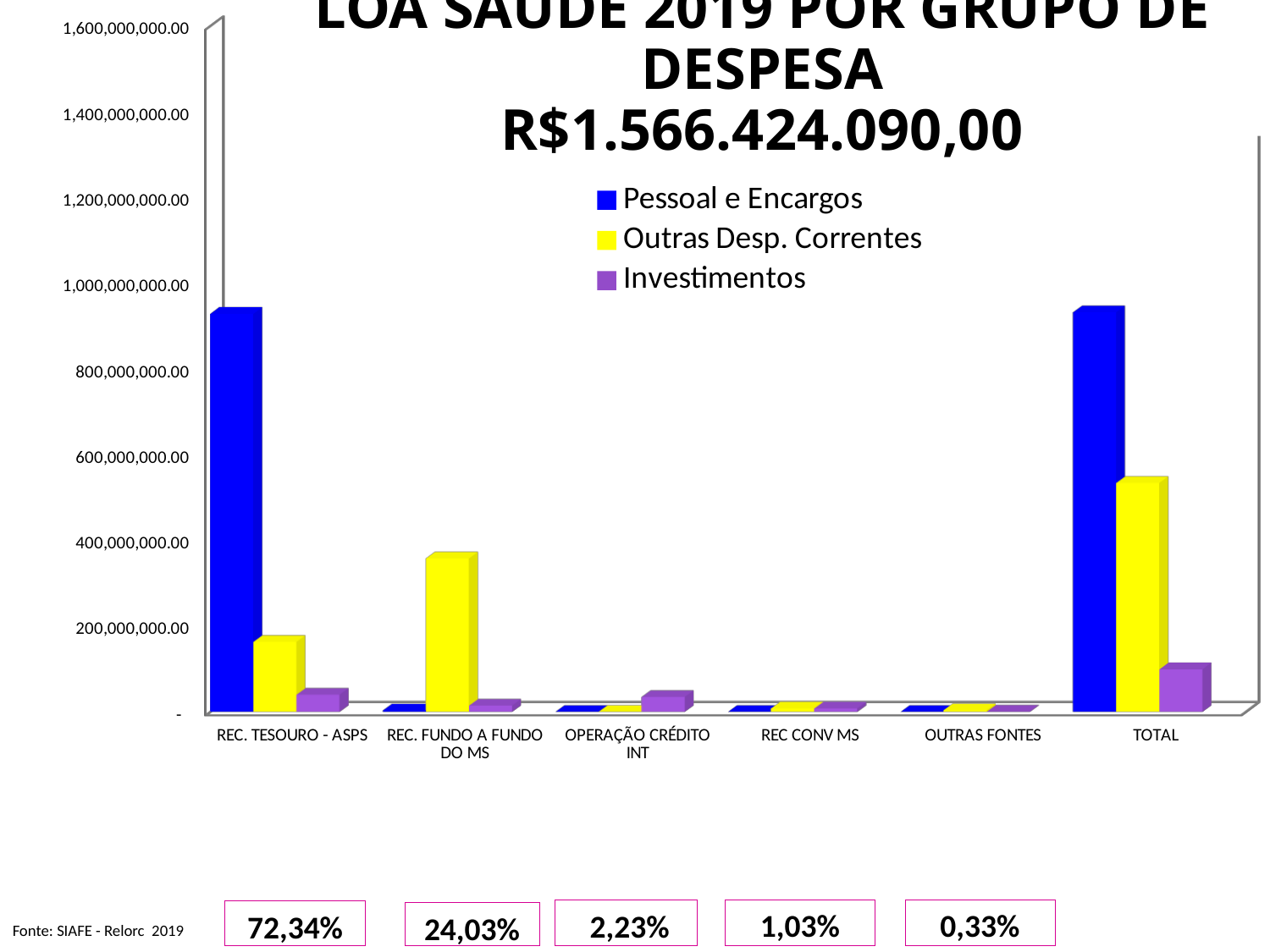
Which series are listed in the legend? Pessoal e Encargos, Outras Desp. Correntes, Investimentos For REC. TESOURO - ASPS, which is larger: Pessoal e Encargos or Outras Desp. Correntes? Pessoal e Encargos Which category has the highest Outras Desp. Correntes value? TOTAL Is the Outras Desp. Correntes value for REC. FUNDO A FUNDO DO MS greater or less than 200,000,000.00? greater What kind of chart is shown on the slide? bar chart For REC. FUNDO A FUNDO DO MS, which is larger: Pessoal e Encargos or Outras Desp. Correntes? Outras Desp. Correntes What colour represents the Investimentos series? purple Is the Outras Desp. Correntes value for TOTAL greater or less than 400,000,000.00? greater Is the Pessoal e Encargos value for REC. TESOURO - ASPS greater or less than 800,000,000.00? greater How many categories are shown along the x axis? 6 How many series does the legend list? 3